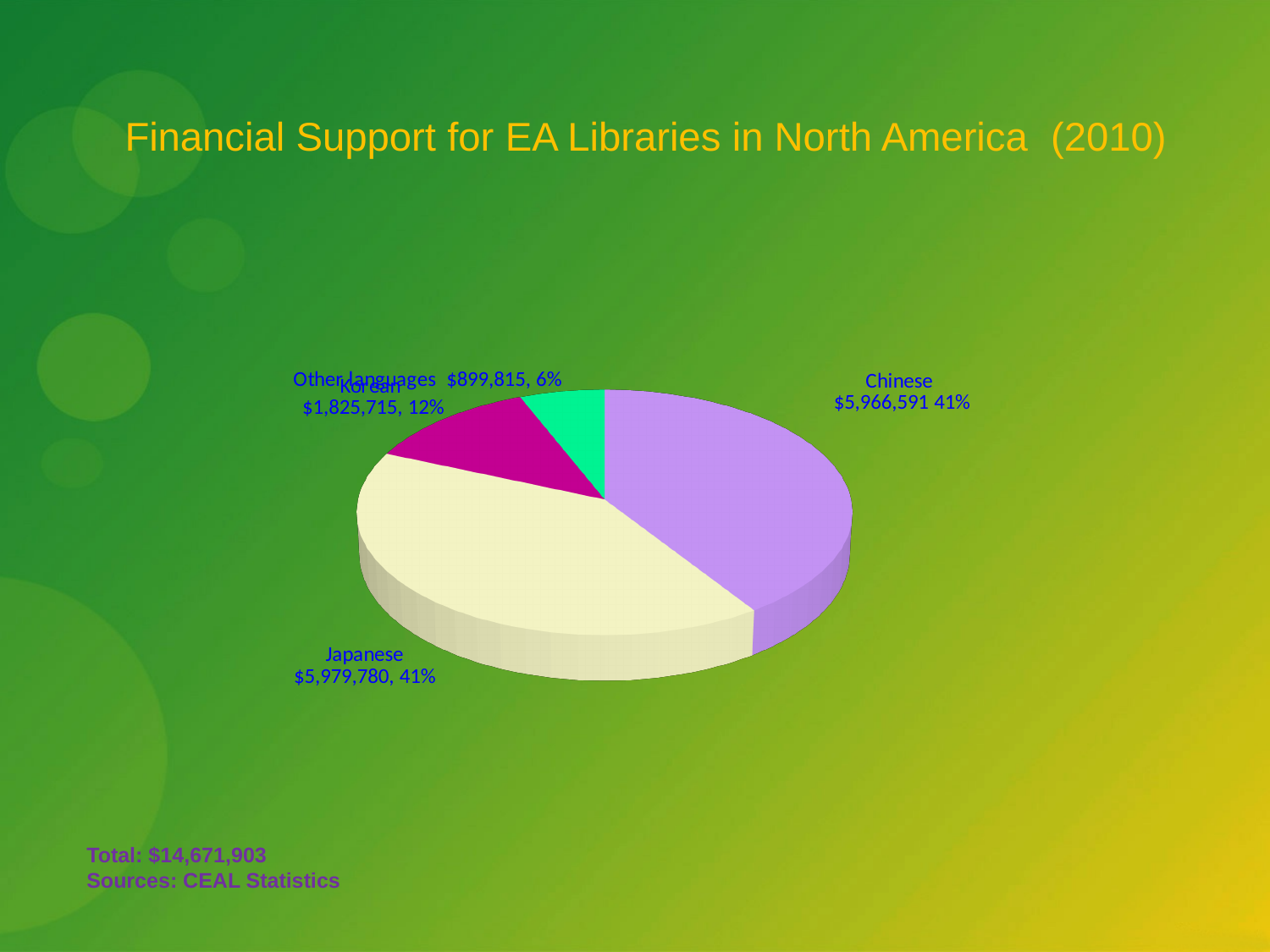
What share of the pie does the Other languages slice represent? 6% Which category has the smallest slice of the pie? Other languages What kind of chart is shown on the slide? Pie chart What is the difference between the Korean value and the Other languages value? $925,900 What is the value shown for the Other languages slice? $899,815 What is the value shown for the Japanese slice? $5,979,780 What is the value shown for the Chinese slice? $5,966,591 What is the value shown for the Korean slice? $1,825,715 What share of the pie does the Korean slice represent? 12% How many slices does the pie chart have? 4 What is the title of the chart? Financial Support for EA Libraries in North America (2010) Which is larger, the Korean value or the Other languages value? Korean